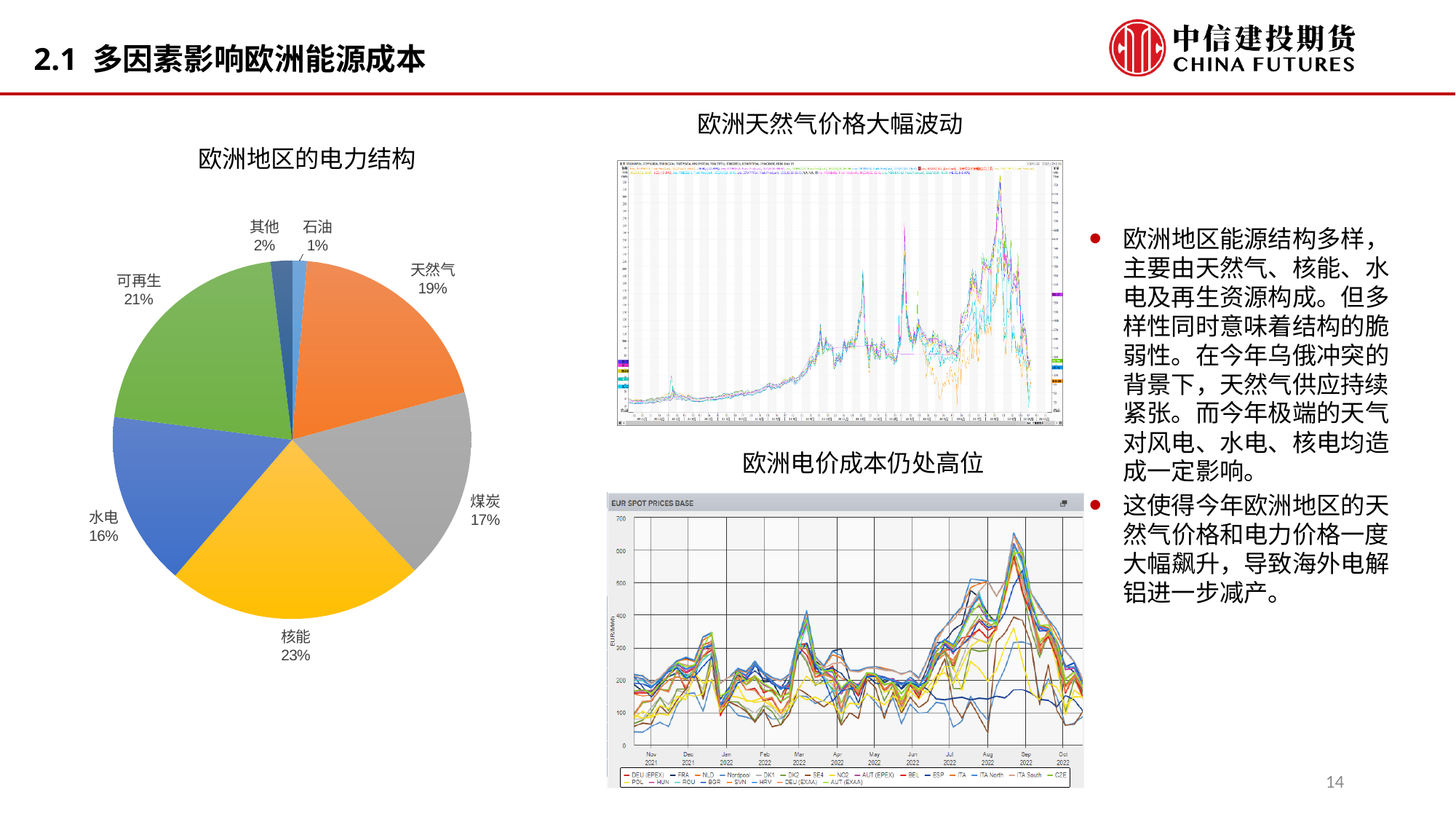
What is the title of the chart at the top right of the slide? 欧洲天然气价格大幅波动 In the pie chart 欧洲地区的电力结构, which is larger, 天然气 or 煤炭? 天然气 In the pie chart 欧洲地区的电力结构, which category has the smallest share? 石油 How many categories are shown in the pie chart 欧洲地区的电力结构? 7 In the pie chart 欧洲地区的电力结构, what is the combined share of 天然气 and 核能? 42% What kind of chart is 欧洲电价成本仍处高位 at the bottom right of the slide? line chart In the pie chart 欧洲地区的电力结构, what share does 水电 have? 16% In the pie chart 欧洲地区的电力结构, which category has the largest share? 核能 What kind of chart is 欧洲地区的电力结构? pie chart In the pie chart 欧洲地区的电力结构, what share does 天然气 have? 19% In the pie chart 欧洲地区的电力结构, what share does 核能 have? 23% In the pie chart 欧洲地区的电力结构, how many percentage points larger is 可再生 than 水电? 5%